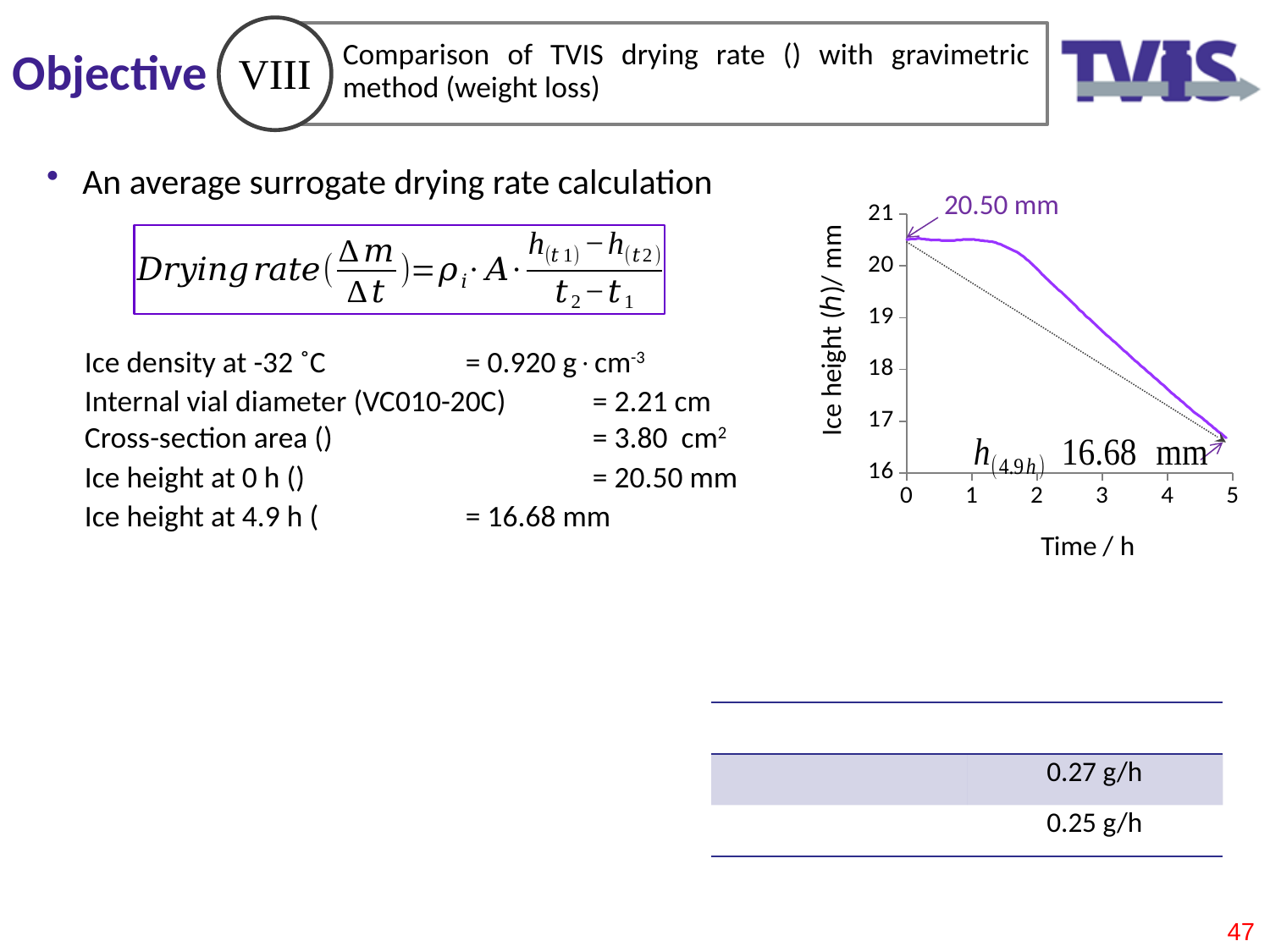
What is the highest value shown on the y axis of the chart? 21 What is the ice height at 0 h according to the chart label? 20.50 mm Does the ice height rise or fall as time increases along the x axis? fall What is the title of the x axis of the chart? Time / h Which is larger, the ice height at 0 h or at 4.9 h? 0 h Is the ice height at 4 h greater or less than 18 mm? less Is the ice height at 1 h greater or less than 20 mm? greater What is the difference between the labelled ice height at 0 h and at 4.9 h? 3.82 mm What kind of chart is shown on the slide? line chart Is the ice height at 3 h greater or less than 19 mm? less What is the title of the y axis of the chart? Ice height (h)/ mm What is the ice height at 4.9 h according to the chart label? 16.68 mm